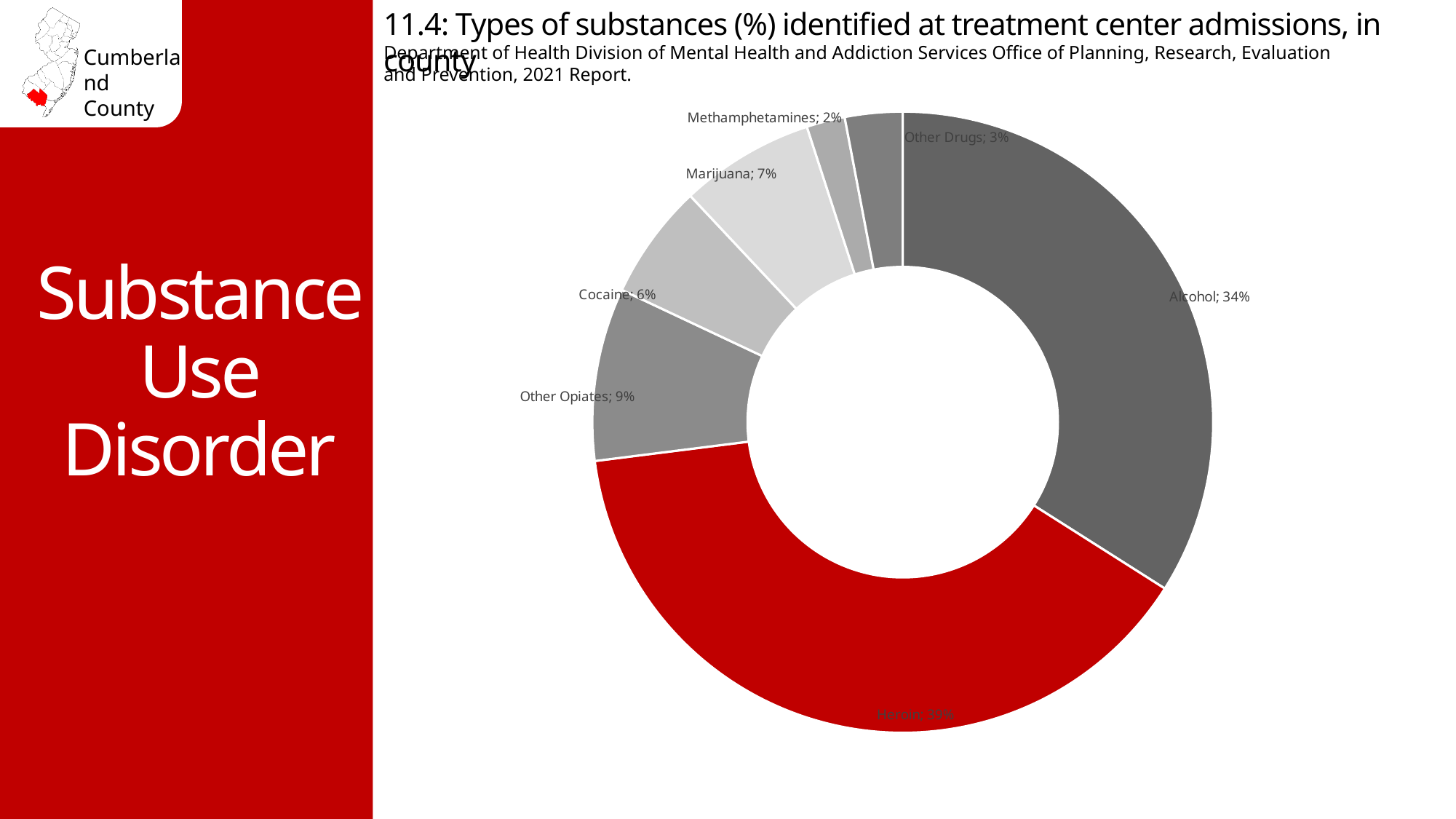
Which substance has the smallest share of admissions? Methamphetamines What percentage is shown for Other Opiates? 9% Which has a larger share, Marijuana or Cocaine? Marijuana What kind of chart is shown on the slide? Pie chart (doughnut) What percentage is shown for Cocaine? 6% What percentage of treatment center admissions identified Alcohol? 34% How many substance categories are shown in the chart? 7 What percentage is shown for Methamphetamines? 2% What is the difference in percentage points between Alcohol and Other Opiates? 25 What percentage is shown for Other Drugs? 3% What percentage is shown for Marijuana? 7% Which substance has the largest share of admissions? Heroin